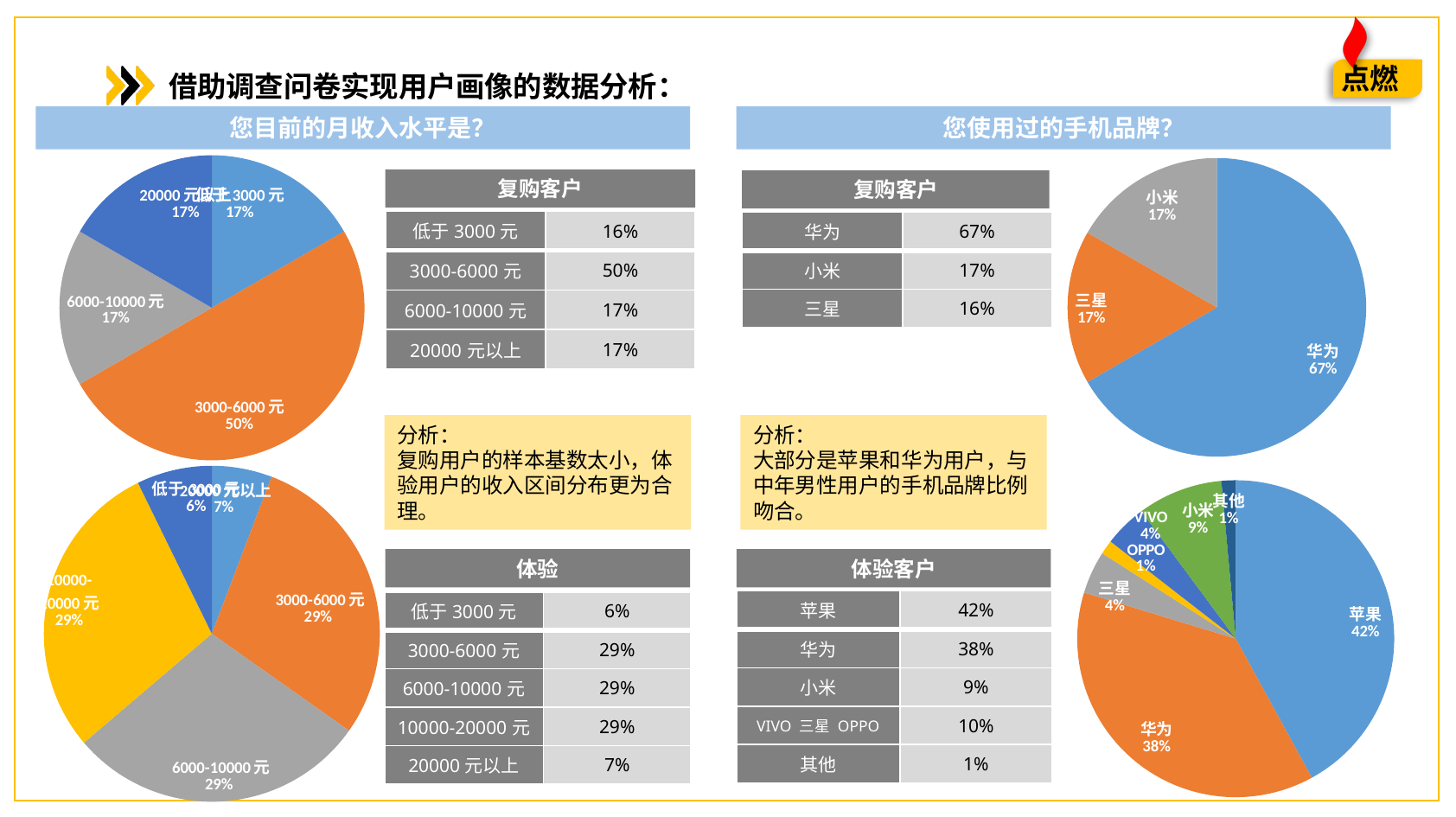
In the top-right pie chart (phone brands of repeat customers), which brand has the largest slice? 华为 In the top-left pie chart (monthly income of repeat customers), what share is labelled for 3000-6000 元? 50% In the top-left pie chart (monthly income of repeat customers), what share is labelled for 6000-10000 元? 17% In the bottom-left pie chart (monthly income of experience customers), what share is labelled for 低于 3000 元? 6% In the top-left pie chart (monthly income of repeat customers), which income range has the largest slice? 3000-6000 元 In the bottom-right pie chart (phone brands of experience customers), what is the difference between the 苹果 share and the 华为 share? 4% In the bottom-left pie chart (monthly income of experience customers), which income range has the smallest slice? 低于 3000 元 In the bottom-right pie chart (phone brands of experience customers), which is larger, the 小米 slice or the 三星 slice? 小米 In the top-right pie chart (phone brands of repeat customers), what share is labelled for 华为? 67% What type of chart is used for the four charts on this slide? Pie chart In the bottom-right pie chart (phone brands of experience customers), what share is labelled for 华为? 38% How many slices does the bottom-left pie chart (monthly income of experience customers) have? 5